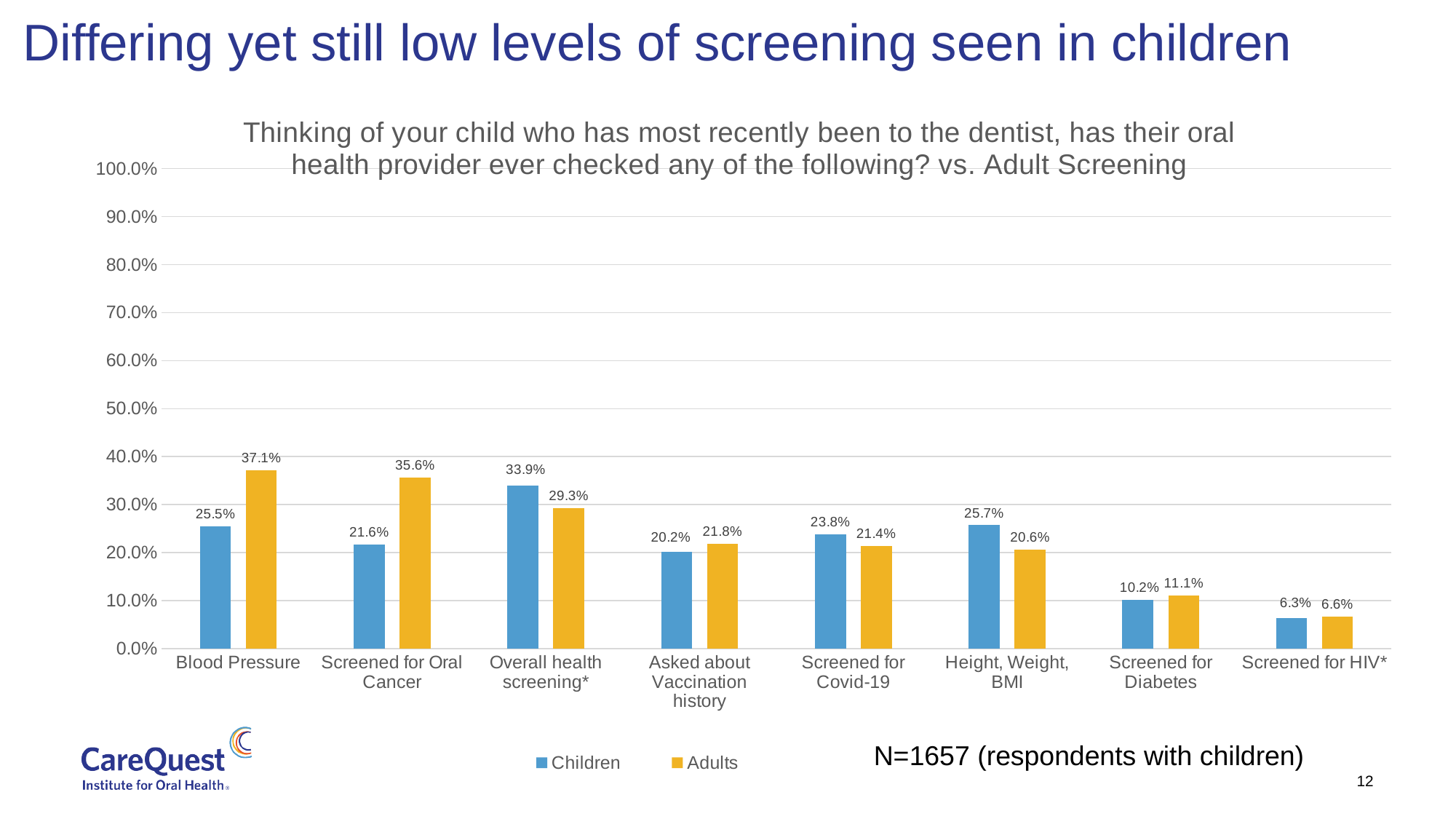
What is the Children value for Overall health screening*? 33.9% Which colour represents the Adults series? Yellow What is the Children value for Blood Pressure? 25.5% For Overall health screening*, which series has the larger value, Children or Adults? Children Which category has the highest Adults value? Blood Pressure Which category has the lowest Children value? Screened for HIV* How many categories are shown on the x axis? 8 Is the Adults value for Screened for Oral Cancer greater or less than 30.0%? greater How many series does the legend list? 2 What is the Adults value for Screened for Oral Cancer? 35.6% What kind of chart is shown on the slide? Bar chart What is the difference between the Adults and Children values for Blood Pressure? 11.6%